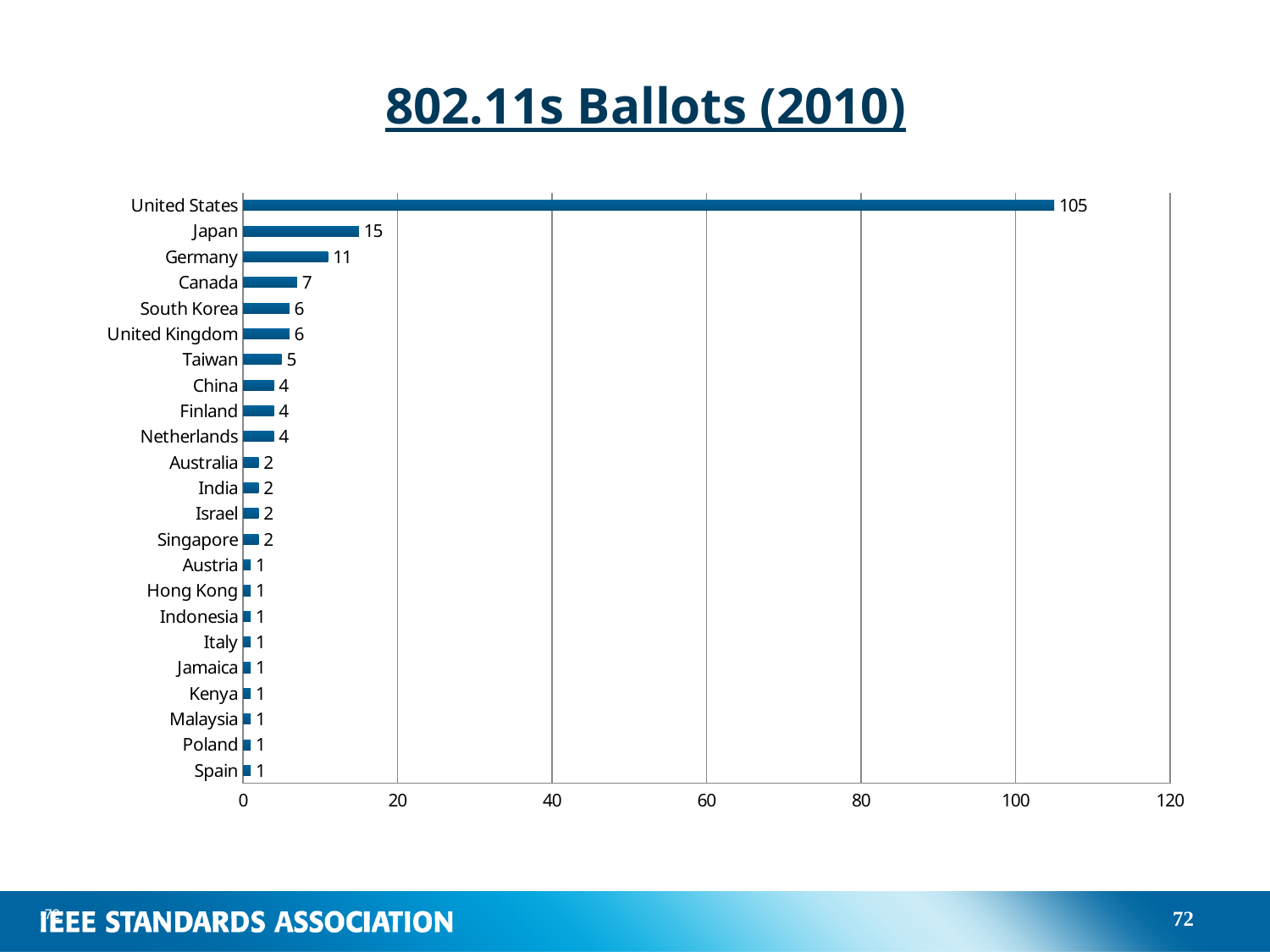
What is the value shown for Taiwan? 5 What kind of chart is shown on the slide? Bar chart What is the value shown for Germany? 11 What is the title of the chart? 802.11s Ballots (2010) Which has a larger value, Japan or Germany? Japan How many ballots does the chart show for the United States? 105 How many countries are listed on the chart? 23 What is the difference between the values for the United States and Japan? 90 Which country has the highest number of ballots? United States Is the value for the United States greater or less than 100? greater What is the difference between the values for Germany and Canada? 4 What is the value shown for Japan? 15